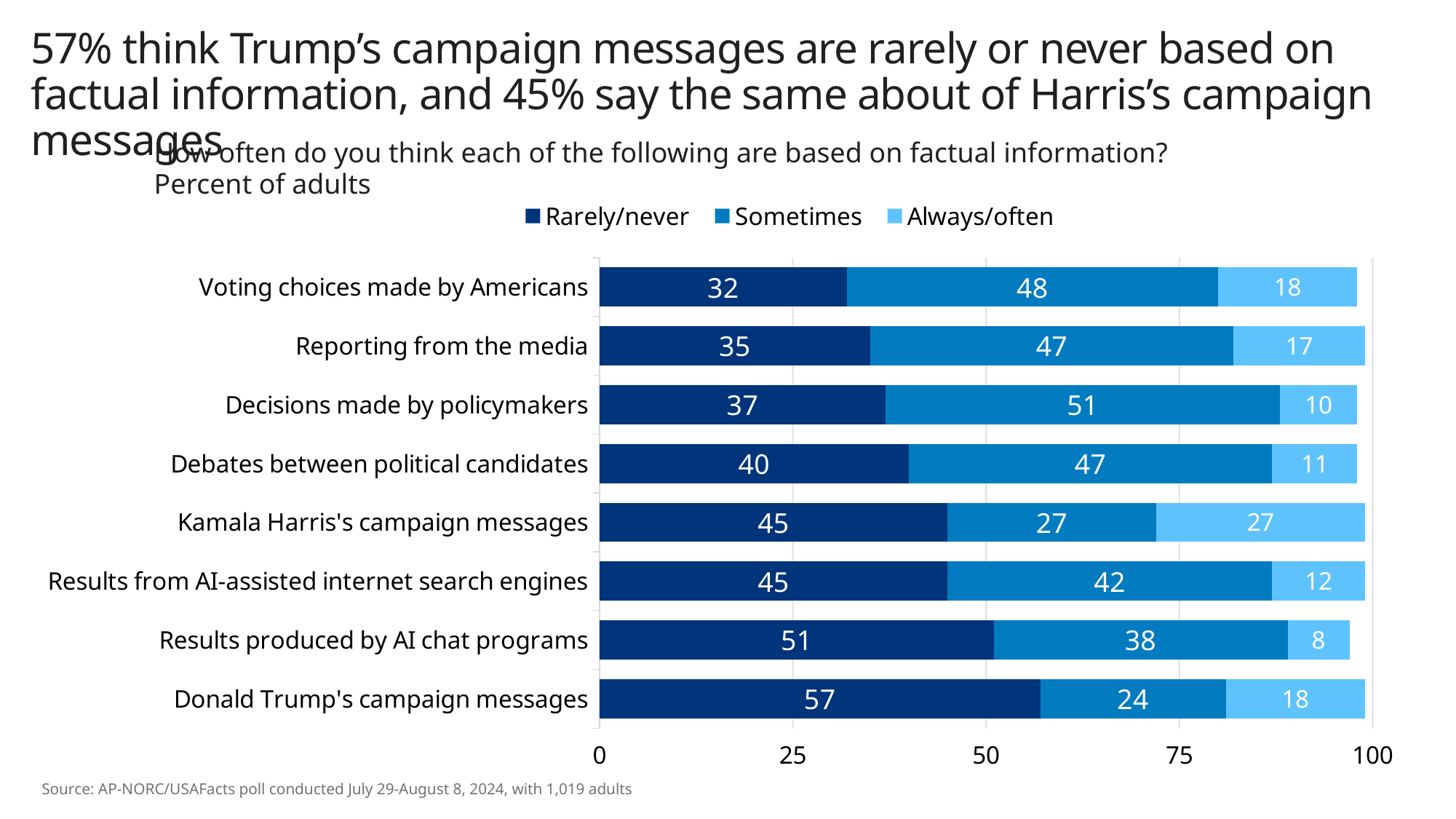
Which category has the lowest Rarely/never value? Voting choices made by Americans What kind of chart is shown on the slide? Stacked bar chart What is the Always/often value for Kamala Harris's campaign messages? 27 Which category has the highest Rarely/never value? Donald Trump's campaign messages What is the total of the stacked bar for Results from AI-assisted internet search engines? 99 What is the Sometimes value for Decisions made by policymakers? 51 How many series does the legend list? 3 Which category has the lowest Always/often value? Results produced by AI chat programs How many categories are shown in the chart? 8 What percentage of adults say Donald Trump's campaign messages are rarely/never based on factual information? 57 What is the difference between the Rarely/never values for Donald Trump's campaign messages and Kamala Harris's campaign messages? 12 Which is larger: the Sometimes value for Voting choices made by Americans or the Sometimes value for Results produced by AI chat programs? Voting choices made by Americans